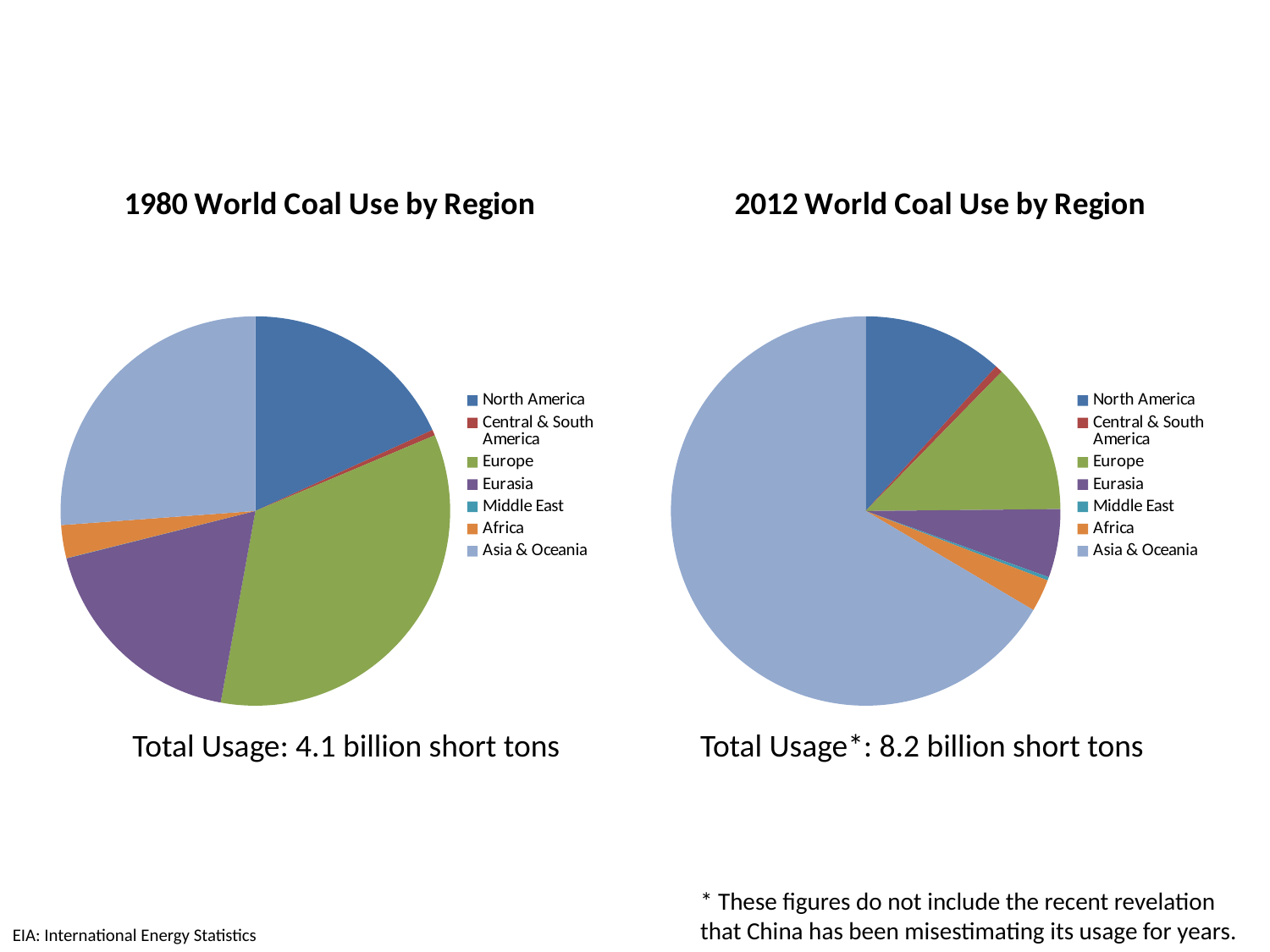
What kind of chart is the 1980 World Coal Use by Region chart? pie chart In the 1980 World Coal Use by Region chart, which slice is larger, North America or Asia & Oceania? Asia & Oceania How many slices does the 1980 World Coal Use by Region pie chart have according to its legend? 7 How many regions does the legend of the 2012 World Coal Use by Region chart list? 7 In the 2012 World Coal Use by Region chart, which region has the largest slice? Asia & Oceania What total usage is stated below the 1980 World Coal Use by Region chart? 4.1 billion short tons In the 1980 World Coal Use by Region chart, which slice is larger, Eurasia or Africa? Eurasia In the 1980 World Coal Use by Region chart, which region has the largest slice? Europe What is the title of the chart on the right side of the slide? 2012 World Coal Use by Region In the 2012 World Coal Use by Region chart, which slice is larger, Europe or Eurasia? Europe